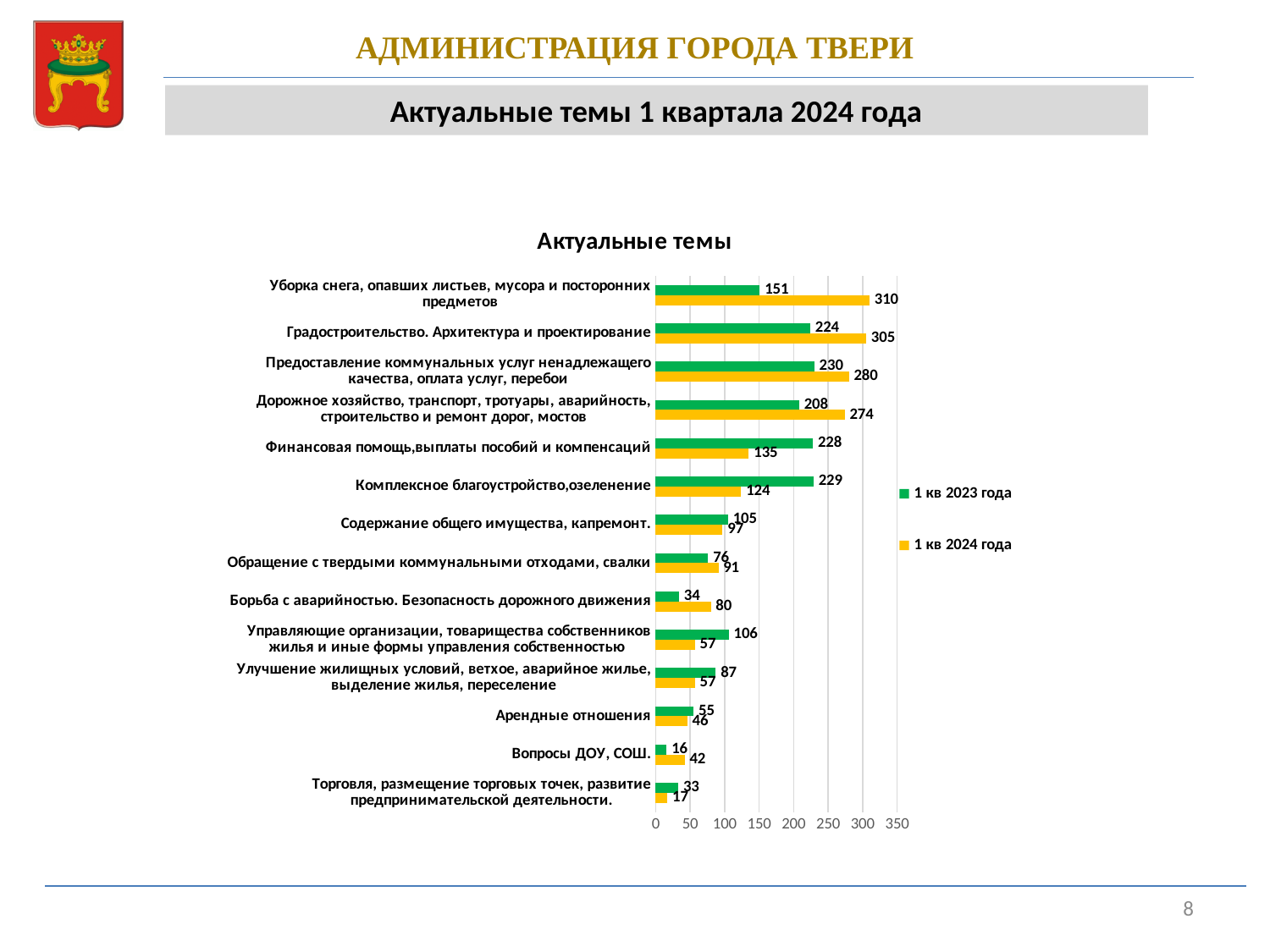
How many categories (topics) are shown in the chart? 14 Which category has the lowest value in the series "1 кв 2023 года"? Вопросы ДОУ, СОШ. What is the value for "Финансовая помощь,выплаты пособий и компенсаций" in the series "1 кв 2023 года"? 228 What is the title of the chart? Актуальные темы What is the value for "Уборка снега, опавших листьев, мусора и посторонних предметов" in the series "1 кв 2024 года"? 310 What is the difference between the 2023 and 2024 values for "Управляющие организации, товарищества собственников жилья и иные формы управления собственностью"? 49 For "Комплексное благоустройство,озеленение", which series has the larger value: "1 кв 2023 года" or "1 кв 2024 года"? 1 кв 2023 года Which category has the highest value in the series "1 кв 2024 года"? Уборка снега, опавших листьев, мусора и посторонних предметов What is the difference between the 2024 and 2023 values for "Уборка снега, опавших листьев, мусора и посторонних предметов"? 159 How many series does the legend of the chart list? 2 What type of chart is shown on the slide? bar chart What is the value for "Вопросы ДОУ, СОШ." in the series "1 кв 2024 года"? 42